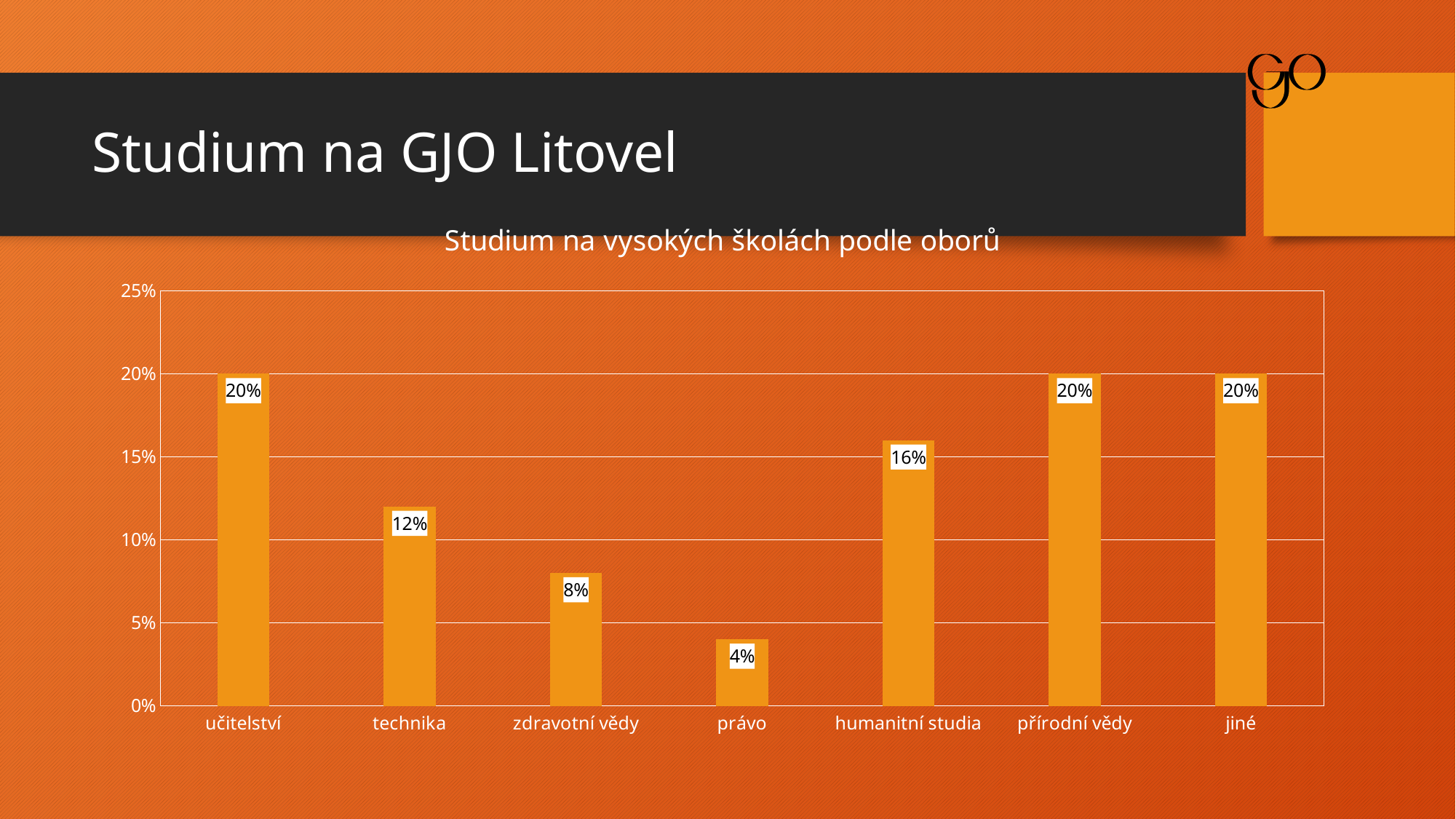
Is the value for humanitní studia greater or less than 15%? greater What is the title of the chart? Studium na vysokých školách podle oborů What is the value for humanitní studia? 16% What is the value for zdravotní vědy? 8% Which category has the lowest value? právo What is the value for technika? 12% What is the value for právo? 4% What kind of chart is shown on the slide? bar chart Which is larger, the value for technika or the value for zdravotní vědy? technika What is the difference between the values for humanitní studia and právo? 12% How many categories are shown on the x axis? 7 What is the difference between the values for učitelství and technika? 8%